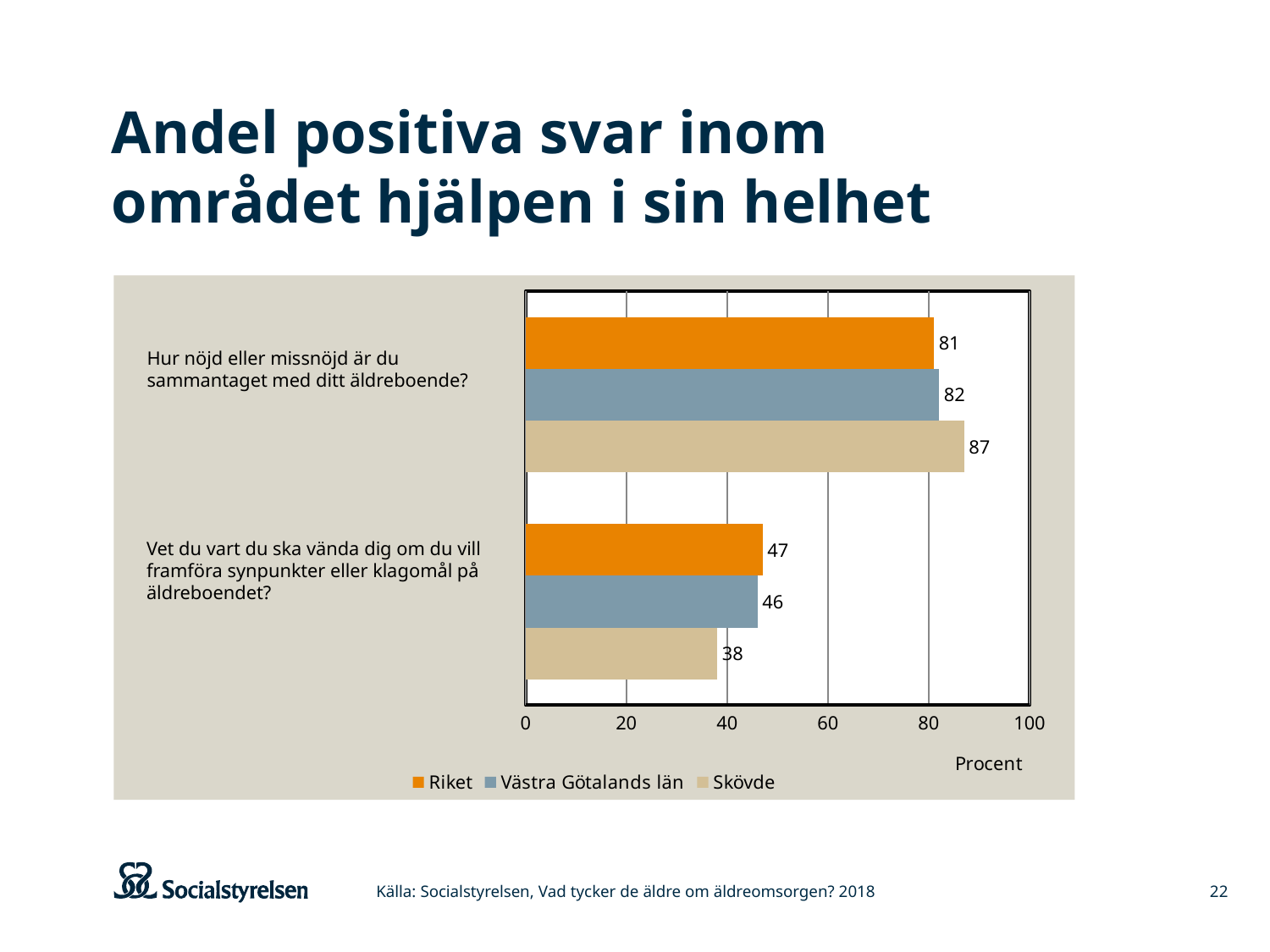
What is the value for Riket on the question "Vet du vart du ska vända dig om du vill framföra synpunkter eller klagomål på äldreboendet?"? 47 Which series has the lowest value on the question "Vet du vart du ska vända dig om du vill framföra synpunkter eller klagomål på äldreboendet?"? Skövde Is the Västra Götalands län value for "Vet du vart du ska vända dig om du vill framföra synpunkter eller klagomål på äldreboendet?" greater or less than 60? less Which is larger: the Skövde value for "Hur nöjd eller missnöjd är du sammantaget med ditt äldreboende?" or the Skövde value for "Vet du vart du ska vända dig om du vill framföra synpunkter eller klagomål på äldreboendet?"? Hur nöjd eller missnöjd är du sammantaget med ditt äldreboende? What is the difference between the Skövde and Riket values on the question "Hur nöjd eller missnöjd är du sammantaget med ditt äldreboende?"? 6 What kind of chart is shown on the slide? bar chart What is the difference between the Riket and Skövde values on the question "Vet du vart du ska vända dig om du vill framföra synpunkter eller klagomål på äldreboendet?"? 9 What is the value for Västra Götalands län on the question "Hur nöjd eller missnöjd är du sammantaget med ditt äldreboende?"? 82 What is the value for Skövde on the question "Hur nöjd eller missnöjd är du sammantaget med ditt äldreboende?"? 87 How many series does the legend list? 3 Which series has the highest value on the question "Hur nöjd eller missnöjd är du sammantaget med ditt äldreboende?"? Skövde What is the label on the horizontal axis of the chart? Procent